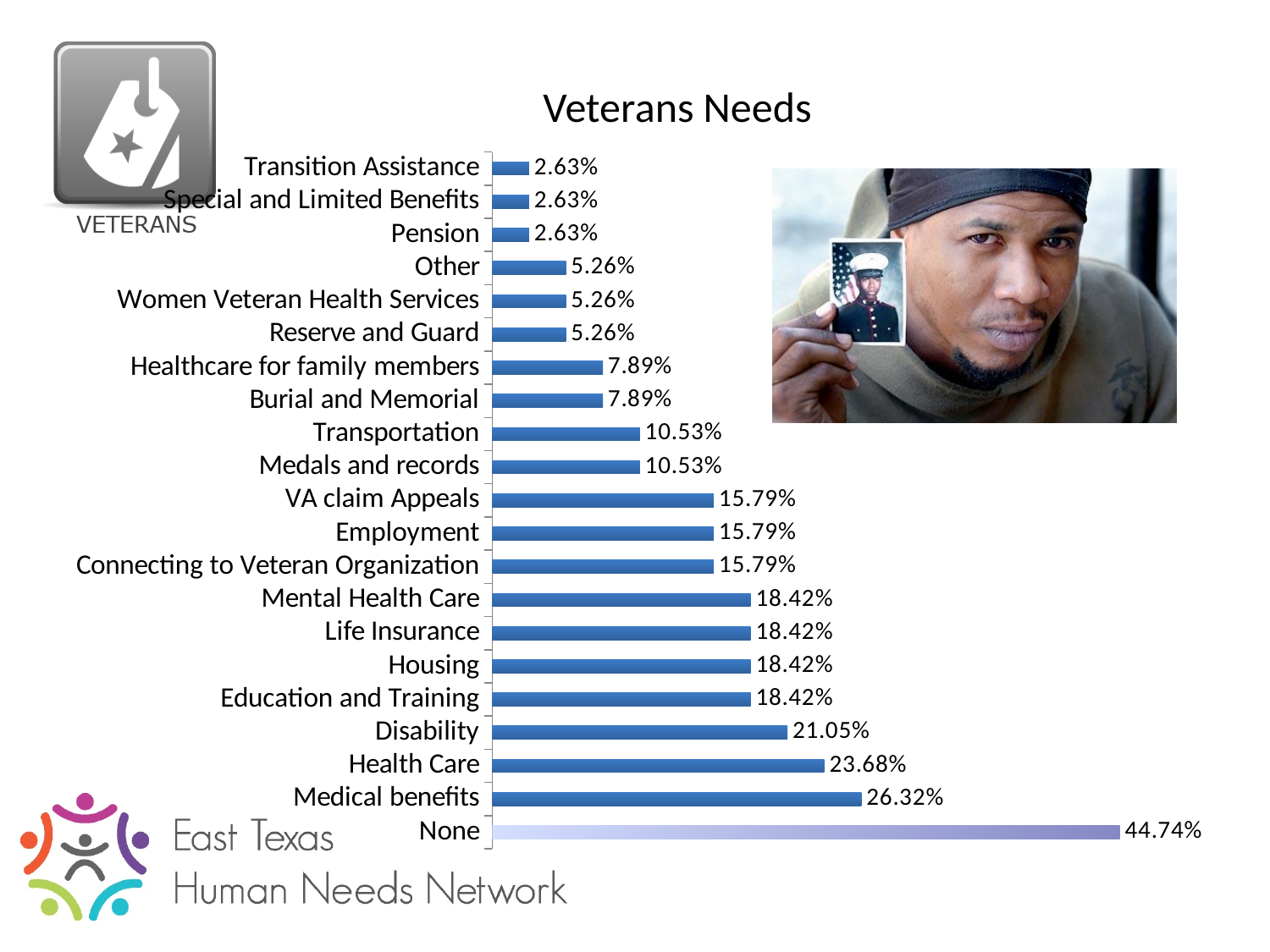
Which category has the highest value? None What is the value for Pension? 2.63% Which is larger, the value for Housing or the value for Employment? Housing How many categories are shown in the chart? 21 Which is larger, the value for Burial and Memorial or the value for Reserve and Guard? Burial and Memorial What is the title of the chart? Veterans Needs What is the value for Disability? 21.05% What is the difference between the values for Health Care and Disability? 2.63% What is the value for Health Care? 23.68% What is the value for Transportation? 10.53% What is the difference between the values for None and Medical benefits? 18.42% What kind of chart is shown on the slide? Bar chart